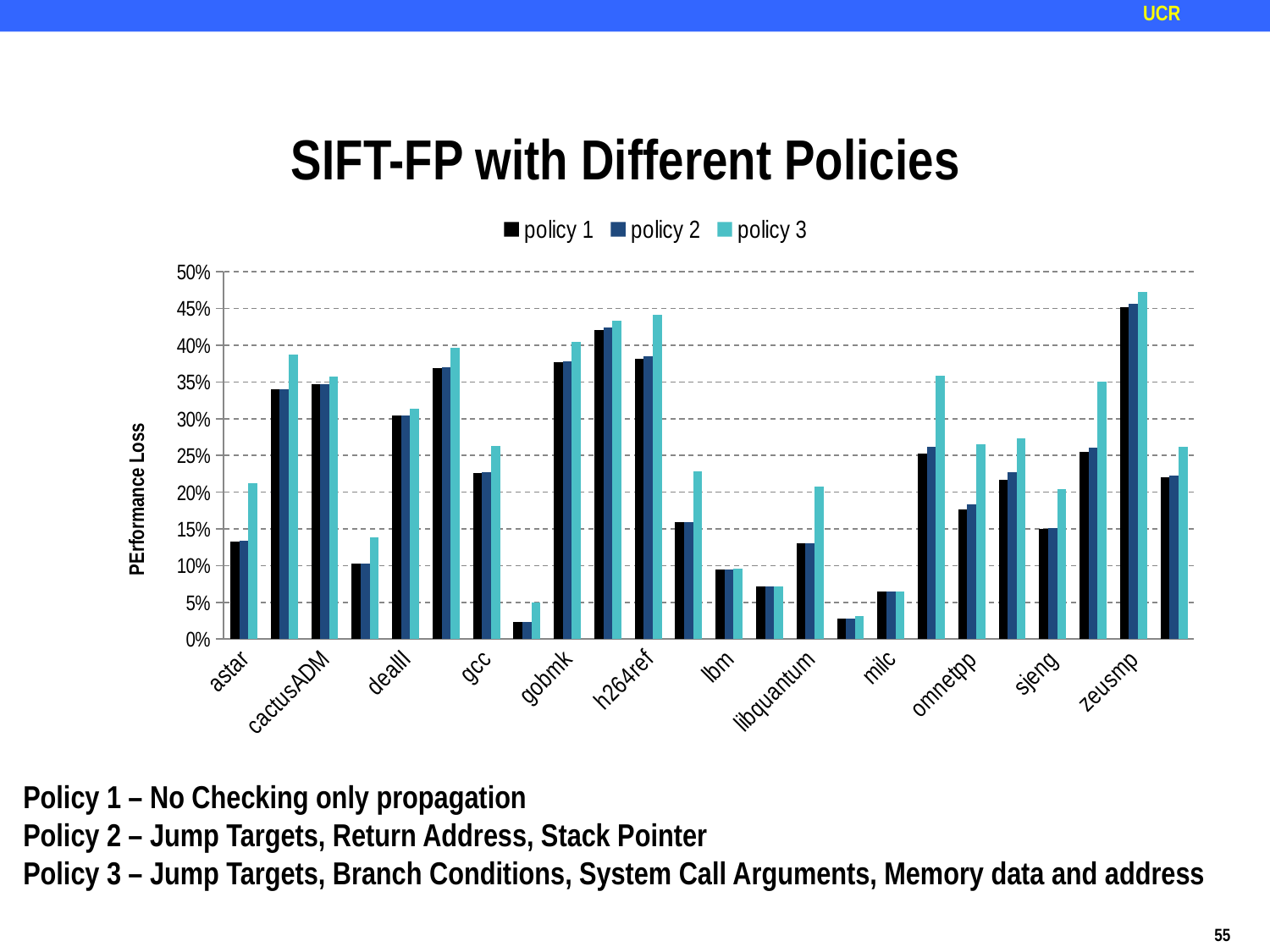
Is the policy 1 value for milc greater or less than 10%? less For h264ref, which is larger: the policy 3 value or the policy 1 value? policy 3 What is the label on the vertical axis of the chart? PErformance Loss Is the policy 1 value for zeusmp greater or less than 20%? greater Is the policy 1 value for cactusADM greater or less than 30%? greater How many series does the legend list? 3 What is the title of the chart? SIFT-FP with Different Policies What kind of chart is shown on the slide? bar chart